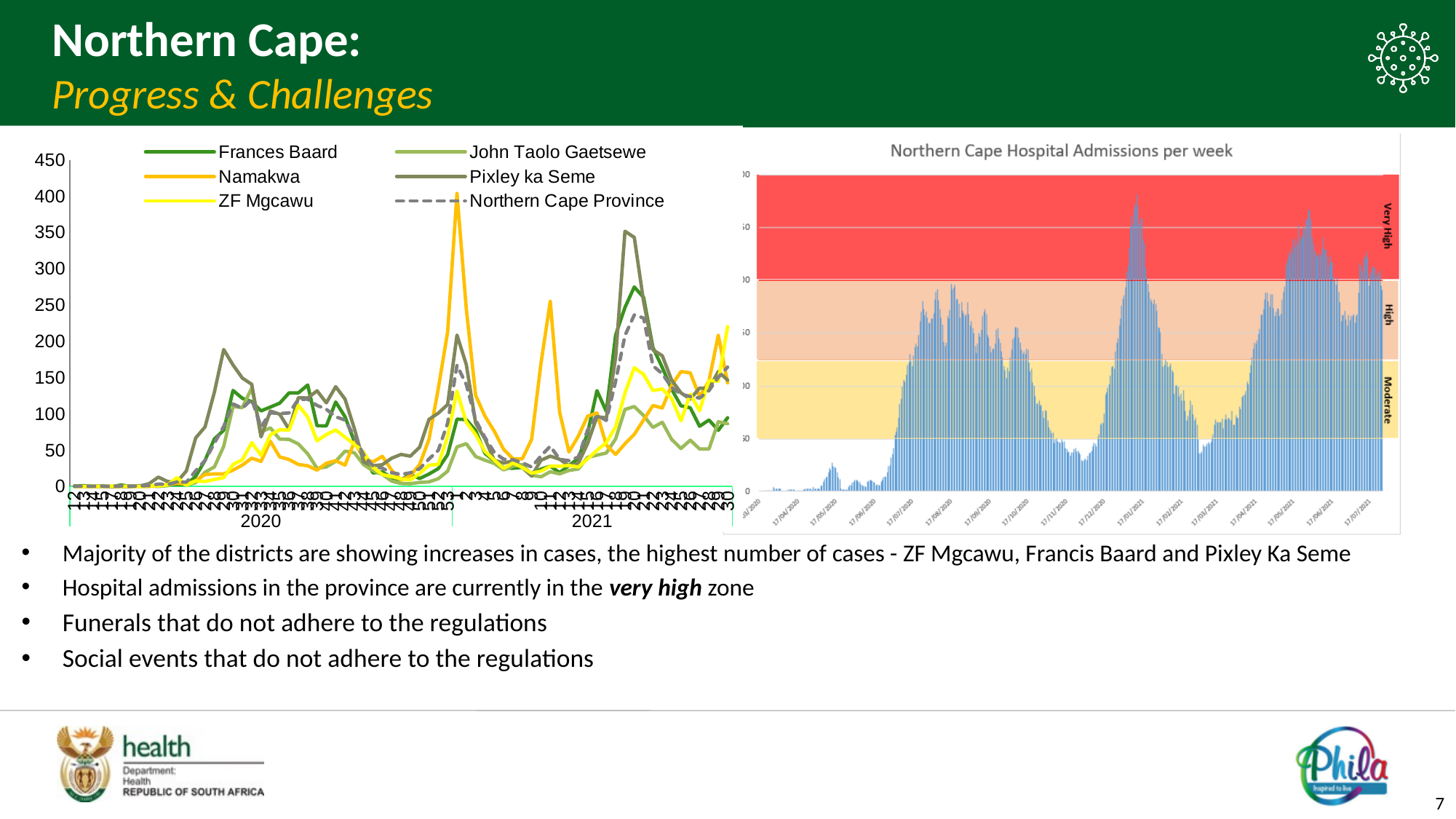
On the left chart, which series is drawn as a dashed grey line? Northern Cape Province On the left chart, which series reaches the highest peak value? Namakwa On the left chart, what is the highest value shown on the vertical axis? 450 What is the title of the right chart? Northern Cape Hospital Admissions per week On the left chart, how many series does the legend list? 6 On the left chart, is the peak value for Frances Baard greater or less than 250? greater On the left chart, is the peak value for John Taolo Gaetsewe greater or less than 150? less What kind of chart is the left chart showing cases by district? line chart On the left chart, is the peak value for Namakwa greater or less than 350? greater What kind of chart is the Northern Cape Hospital Admissions per week chart? bar chart